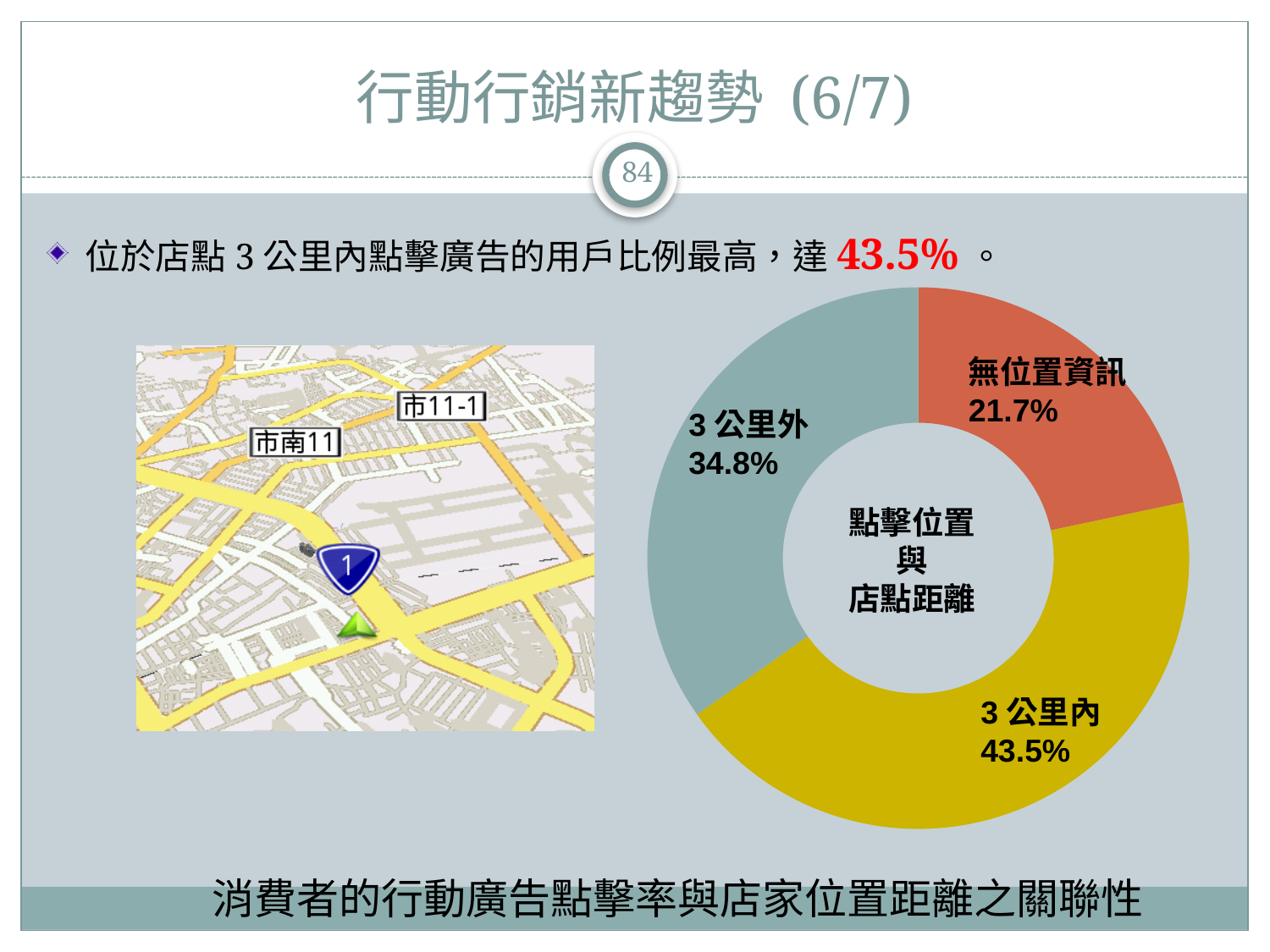
Which is larger, the share for 3 公里外 or the share for 無位置資訊? 3 公里外 How many slices does the donut chart have? 3 Which category has the smallest share of the donut chart? 無位置資訊 Which category has the largest share of the donut chart? 3 公里內 What colour is the 3 公里內 slice of the donut chart? Yellow What kind of chart is shown on the slide? Pie (donut) chart What is the difference between the shares of 3 公里外 and 無位置資訊? 13.1% What is the value for 3 公里內? 43.5% What is the value for 3 公里外? 34.8% What is the value for 無位置資訊? 21.7% What is the difference between the shares of 3 公里內 and 3 公里外? 8.7% What text is written in the centre of the donut chart? 點擊位置與店點距離